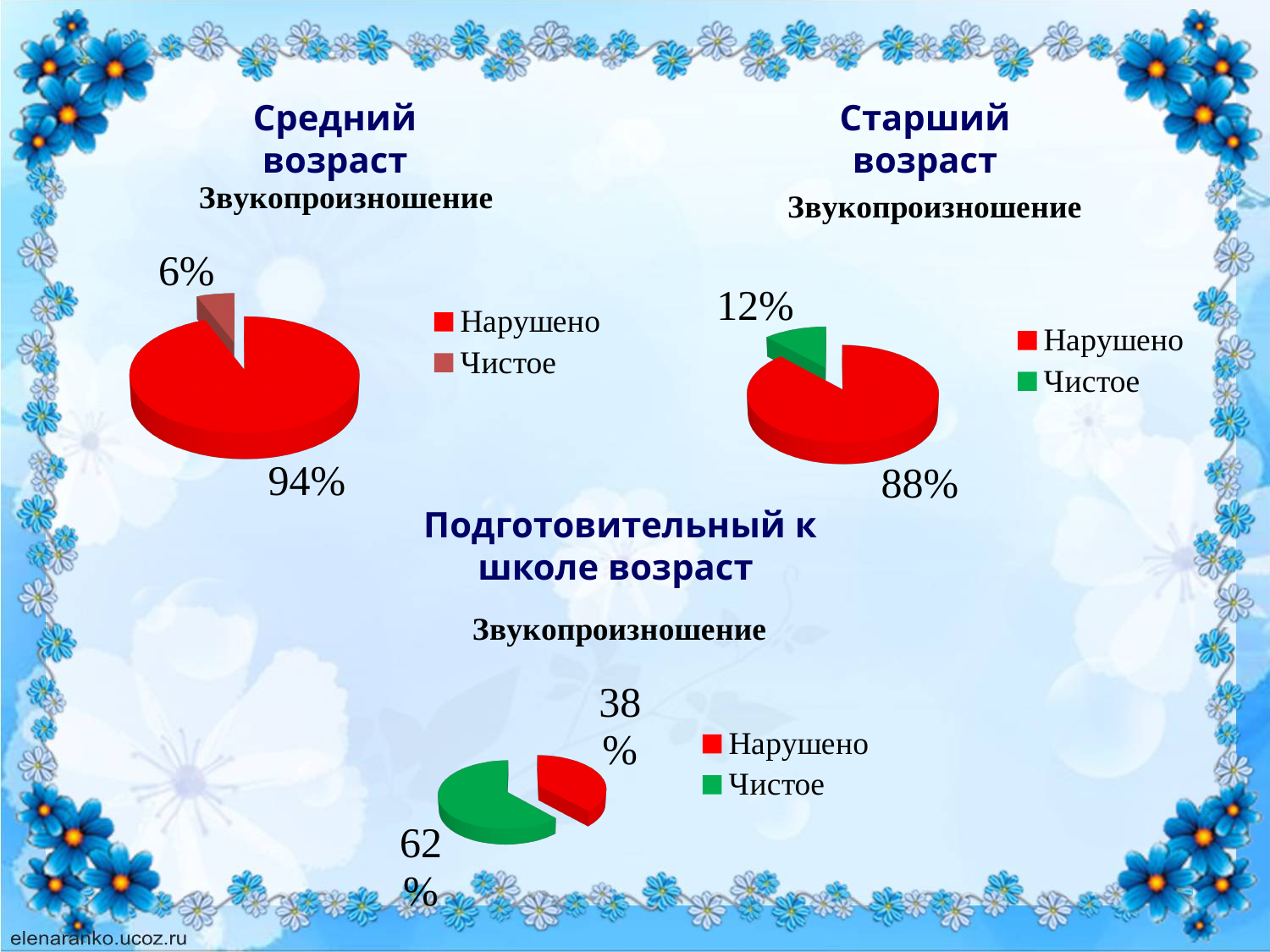
In the "Старший возраст" chart, which slice is the largest? Нарушено In the "Подготовительный к школе возраст" chart, which slice is larger, Нарушено or Чистое? Чистое In the "Старший возраст" chart, what share is labelled for Чистое? 12% In the "Средний возраст" chart, what is the difference between the Нарушено and Чистое shares? 88% In the "Средний возраст" chart, what share is labelled for Чистое? 6% How many pie charts are shown on the slide? 3 In the "Подготовительный к школе возраст" chart, what share is labelled for Нарушено? 38% What kind of chart is used in the "Старший возраст" section? Pie chart In the "Средний возраст" chart, what share is labelled for Нарушено? 94% How many entries does the legend of the "Подготовительный к школе возраст" chart list? 2 In the "Старший возраст" chart, what share is labelled for Нарушено? 88% In the "Подготовительный к школе возраст" chart, what share is labelled for Чистое? 62%